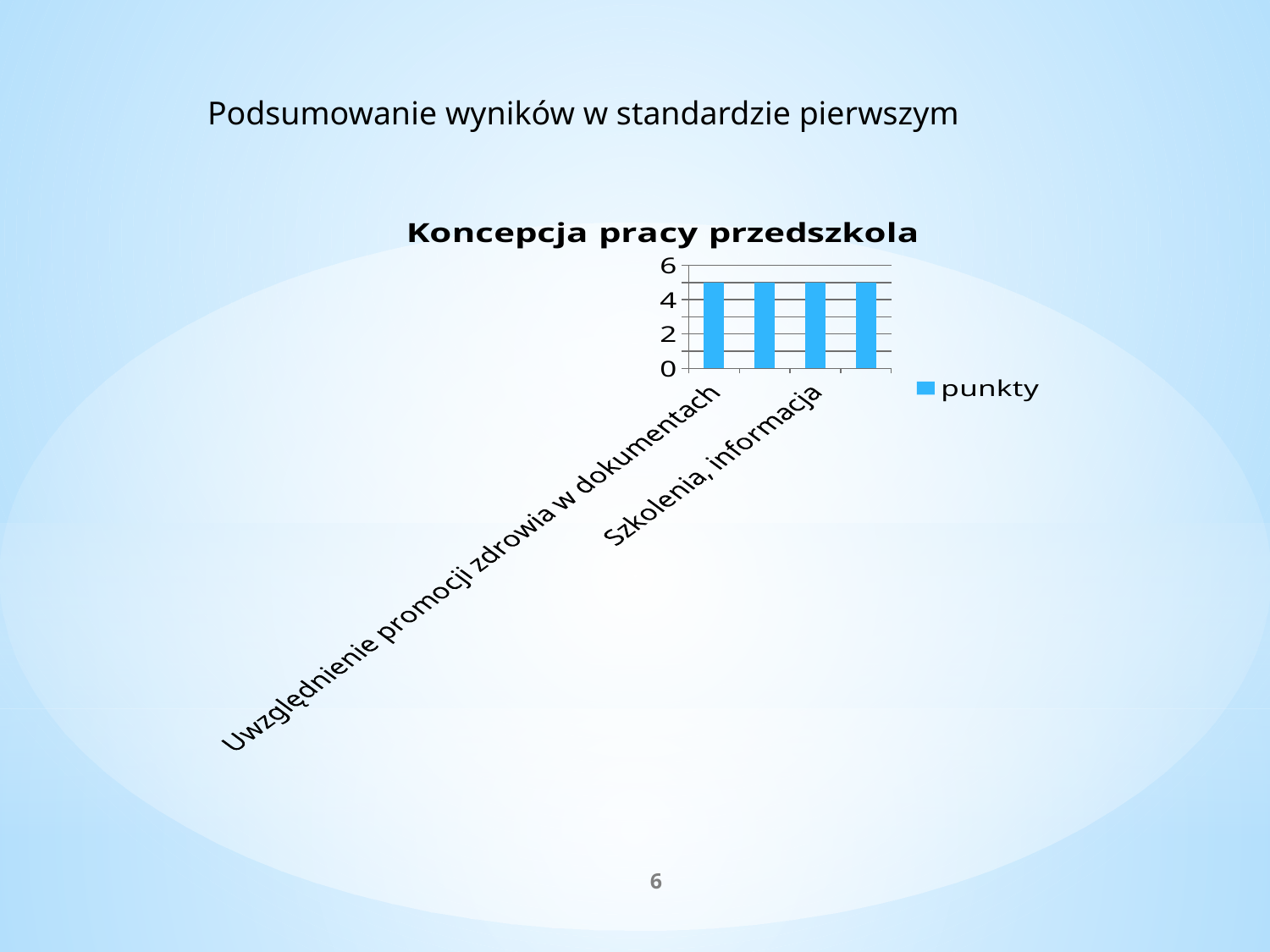
What type of chart is shown on the slide? bar chart How many series does the chart legend list? 1 Is the value for "Szkolenia, informacja" greater or less than 6? less What is the highest value shown on the vertical axis of the chart? 6 What is the name of the series shown in the legend? punkty Is the value for "Uwzględnienie promocji zdrowia w dokumentach" greater or less than 4? greater What is the title of the chart? Koncepcja pracy przedszkola Is the value for "Szkolenia, informacja" greater or less than 2? greater How many bars are plotted in the chart? 4 Do the bar values rise, fall, or stay the same from left to right across the chart? stay the same